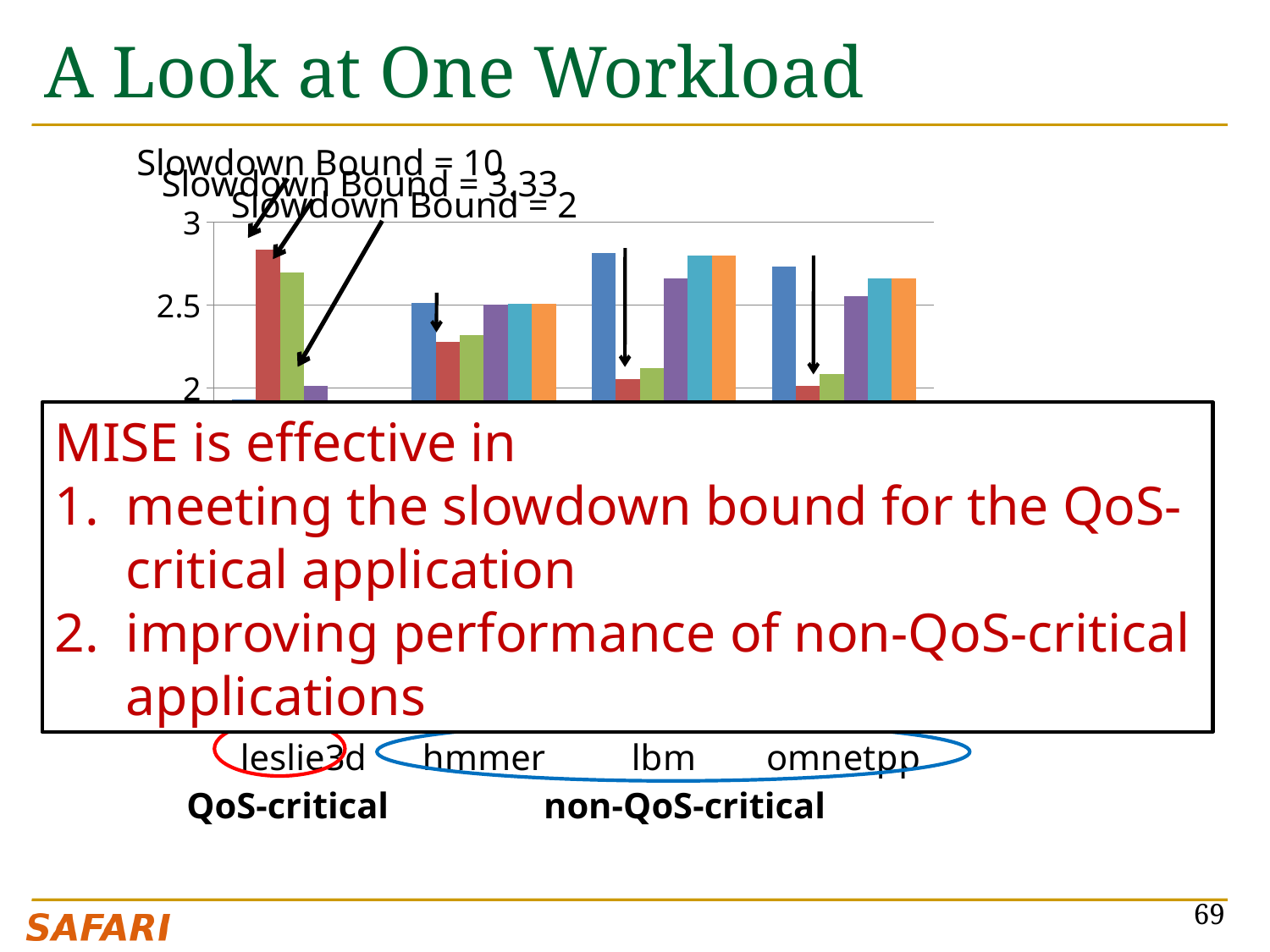
Which categories on the x axis are grouped as non-QoS-critical? hmmer, lbm, omnetpp Which category on the x axis is labeled as QoS-critical? leslie3d For lbm, which bar is taller, the blue bar or the red bar? the blue bar Is the value of the green bar for omnetpp greater or less than 2.5? less For leslie3d, which bar is the tallest? the red bar Is the value of the red bar for hmmer greater or less than 2.5? less What kind of chart is shown on the slide? bar chart Is the value of the red bar for lbm greater or less than 2.5? less How many categories are shown on the x axis of the chart? 4